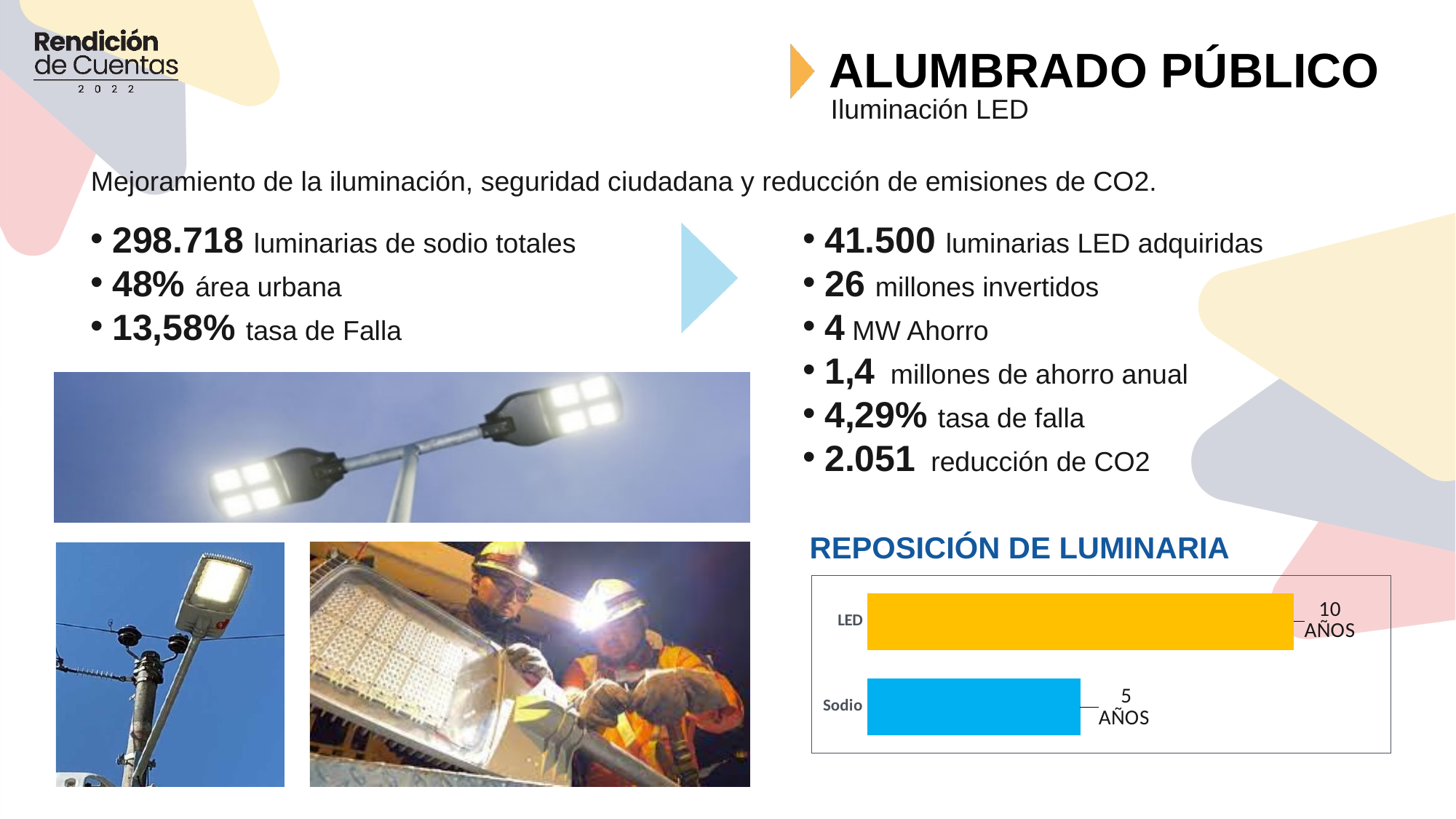
What kind of chart is the REPOSICIÓN DE LUMINARIA chart? bar chart What is the difference in years between LED and Sodio in the REPOSICIÓN DE LUMINARIA chart? 5 AÑOS What colour is the LED bar in the REPOSICIÓN DE LUMINARIA chart? yellow Which is larger in the REPOSICIÓN DE LUMINARIA chart, LED or Sodio? LED What is the value for Sodio in the REPOSICIÓN DE LUMINARIA chart? 5 AÑOS Which category has the lowest value in the REPOSICIÓN DE LUMINARIA chart? Sodio Which category has the highest value in the REPOSICIÓN DE LUMINARIA chart? LED How many categories are shown in the REPOSICIÓN DE LUMINARIA chart? 2 What is the value for LED in the REPOSICIÓN DE LUMINARIA chart? 10 AÑOS What is the title of the chart on the slide? REPOSICIÓN DE LUMINARIA